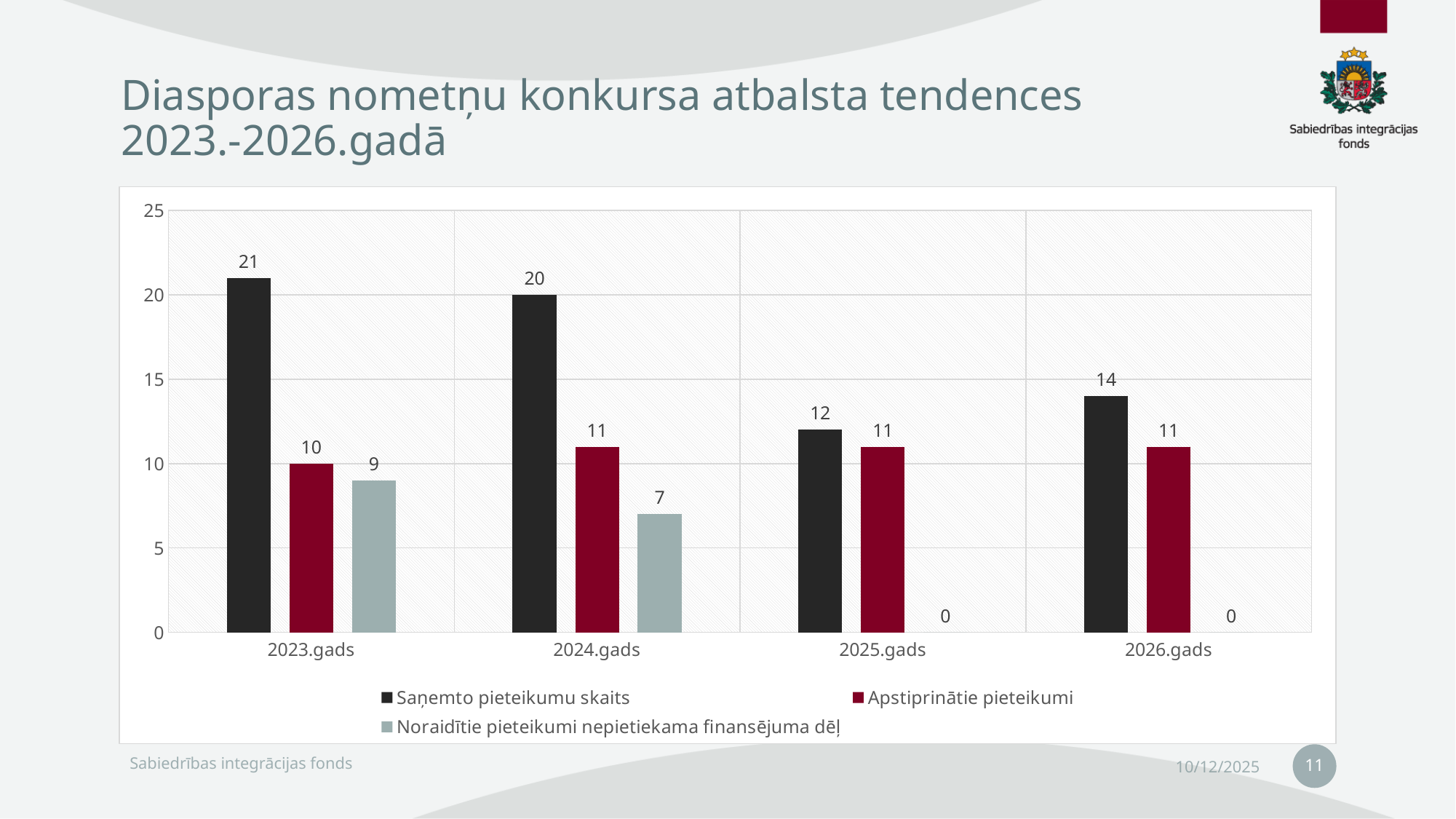
How many series does the legend list? 3 Is the value of Saņemto pieteikumu skaits for 2026.gads greater or less than 15? less How many years are shown on the x axis? 4 What is the value of Noraidītie pieteikumi nepietiekama finansējuma dēļ for 2024.gads? 7 Which year has the lowest value for Saņemto pieteikumu skaits? 2025.gads What is the difference between Saņemto pieteikumu skaits and Apstiprinātie pieteikumi in 2024.gads? 9 Which year has the highest value for Saņemto pieteikumu skaits? 2023.gads What is the value of Apstiprinātie pieteikumi for 2025.gads? 11 What kind of chart is shown on the slide? bar chart What is the value of Noraidītie pieteikumi nepietiekama finansējuma dēļ for 2026.gads? 0 What is the value of Saņemto pieteikumu skaits for 2023.gads? 21 Which is larger in 2023.gads: Apstiprinātie pieteikumi or Noraidītie pieteikumi nepietiekama finansējuma dēļ? Apstiprinātie pieteikumi